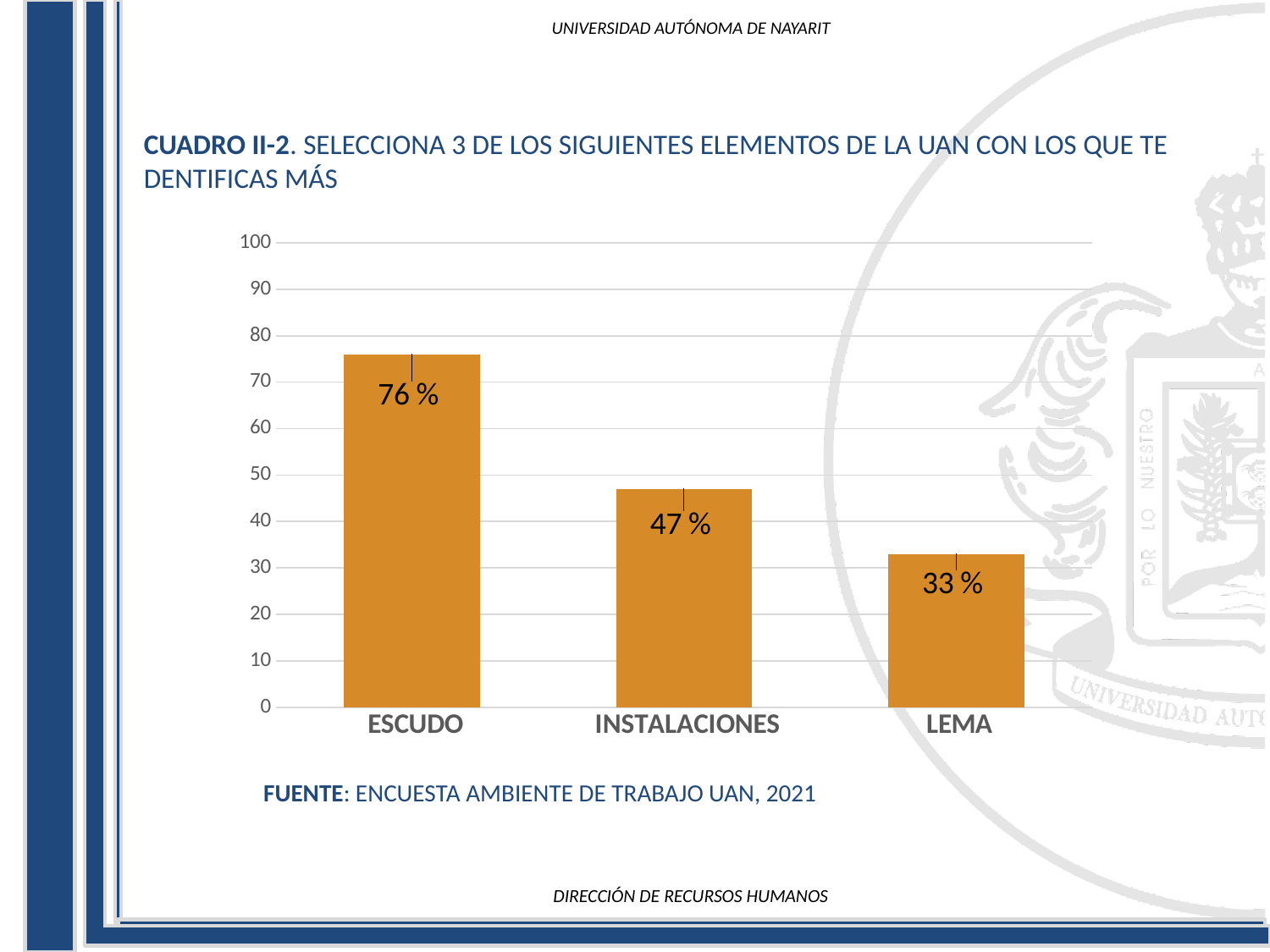
What is the difference between the values for INSTALACIONES and LEMA? 14 % What is the difference between the values for ESCUDO and INSTALACIONES? 29 % What is the value for INSTALACIONES? 47 % Which category has the lowest value? LEMA What kind of chart is shown on the slide? Bar chart How many categories are shown in the chart? 3 What is the value for LEMA? 33 % Which category has the highest value? ESCUDO What is the value for ESCUDO? 76 % Do the values rise or fall from left to right across the categories? Fall Which is larger, the value for INSTALACIONES or the value for LEMA? INSTALACIONES Is the value for ESCUDO greater or less than 70? greater